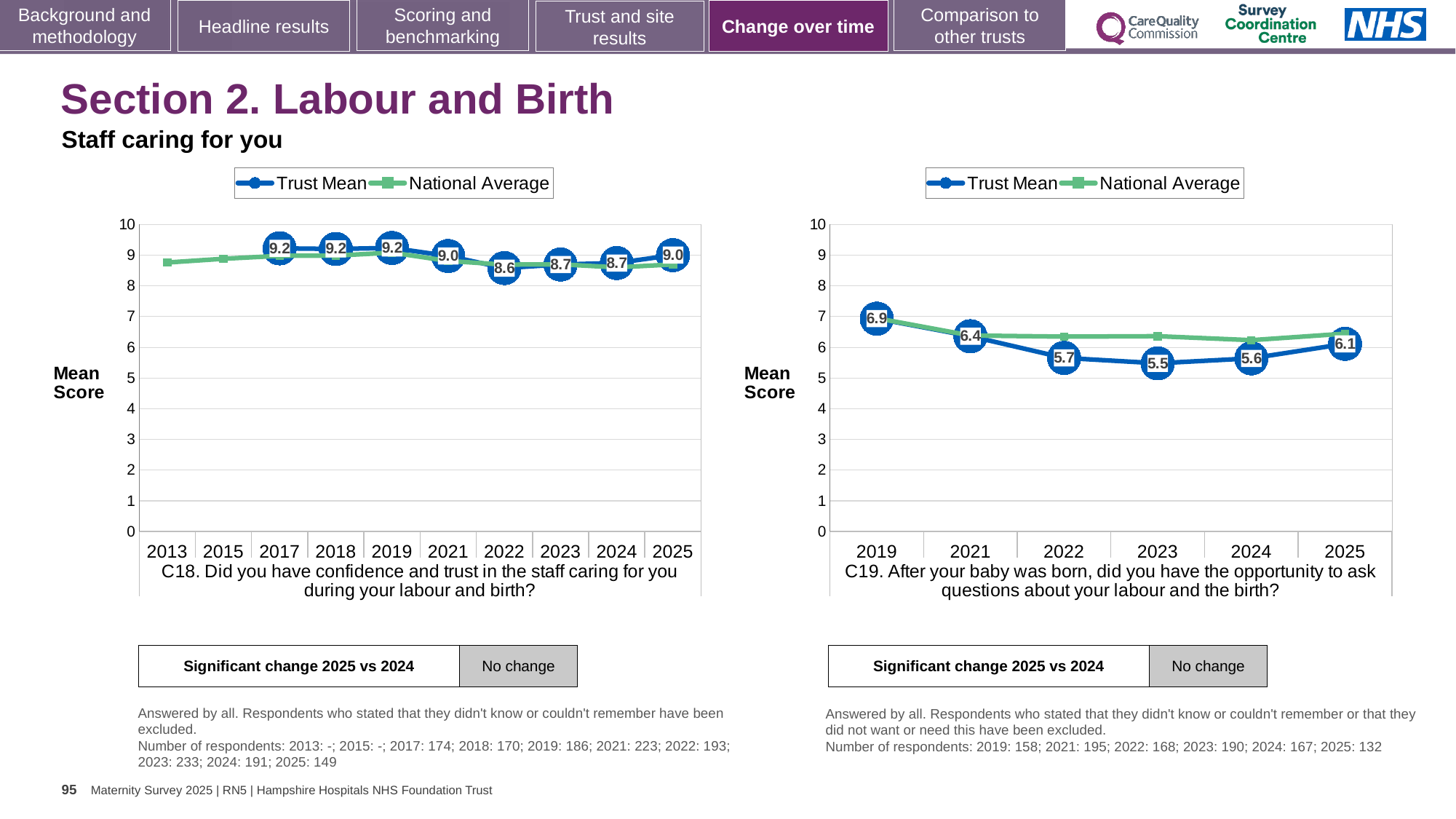
What kind of chart is the C19 chart on the right? Line chart In the C18 chart on the left, how many years are shown on the x axis? 10 In the C19 chart on the right, what is the difference between the Trust Mean scores for 2019 and 2025? 0.8 In the C19 chart on the right, is the Trust Mean score for 2024 greater or less than the Trust Mean score for 2025? less In the C18 chart on the left, what is the Trust Mean score for 2025? 9.0 In the C19 chart on the right, how many series does the legend list? 2 In the C19 chart on the right, which year has the highest Trust Mean score? 2019 In the C18 chart on the left, what is the Trust Mean score for 2022? 8.6 In the C19 chart on the right, which year has the lowest Trust Mean score? 2023 In the C18 chart on the left, which year has the lowest Trust Mean score? 2022 In the C18 chart on the left, what is the difference between the Trust Mean scores for 2019 and 2022? 0.6 In the C19 chart on the right, what is the Trust Mean score for 2019? 6.9